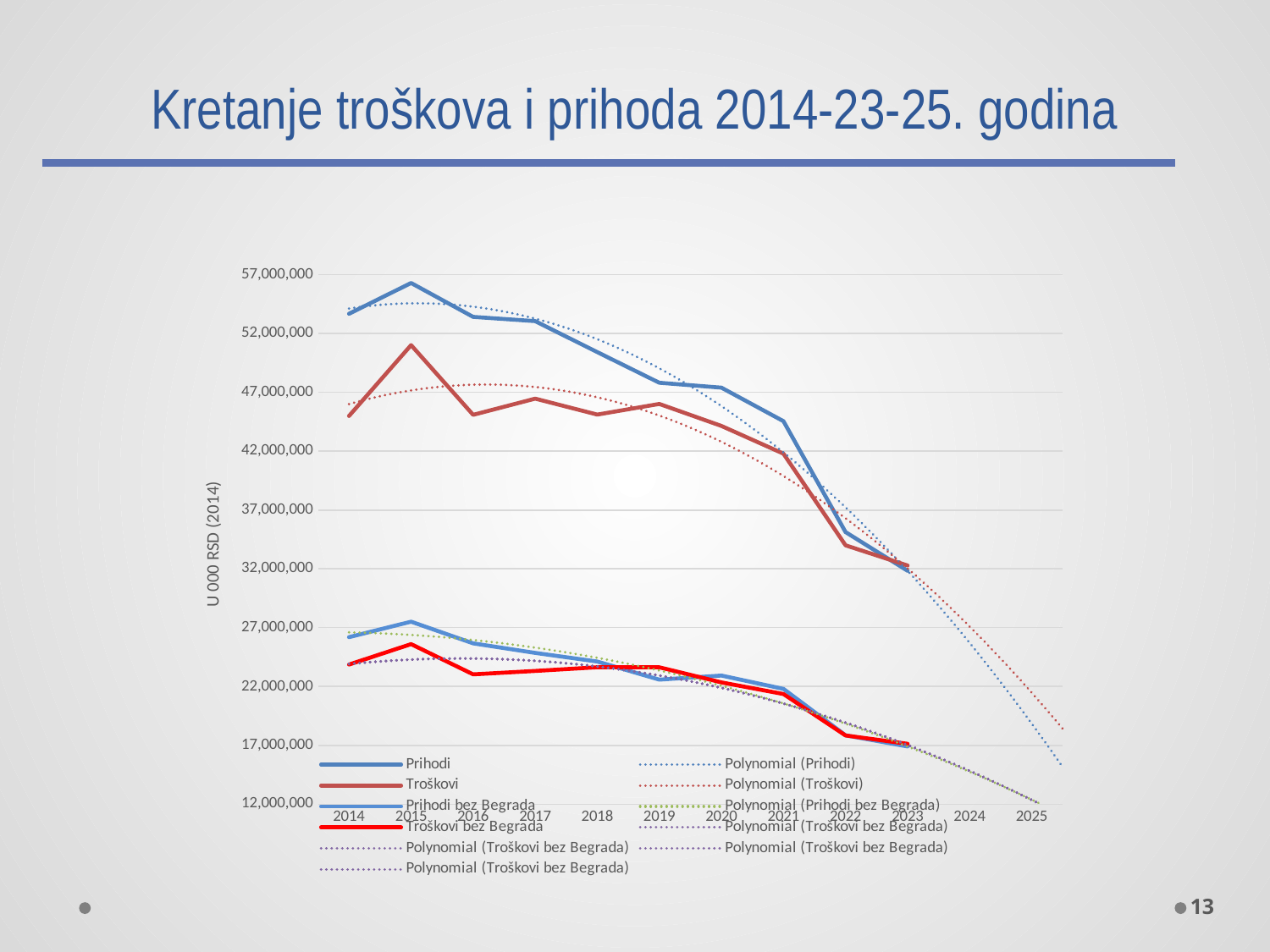
Is the value of Troškovi in 2022 greater or less than 37,000,000? less What is the label on the vertical axis of the chart? U 000 RSD (2014) Is the value of Prihodi in 2015 greater or less than 52,000,000? greater In which year does the Prihodi series reach its highest value? 2015 In which year does the Prihodi series reach its lowest value? 2023 Does the Prihodi series generally rise or fall from 2015 to 2023? fall How many years are labelled along the x axis of the chart? 12 In which year does the Troškovi series reach its highest value? 2015 What kind of chart is shown on the slide? line chart Which series has the larger value in 2015, Prihodi or Troškovi? Prihodi What is the title of the chart? Kretanje troškova i prihoda 2014-23-25. godina Is the value of Prihodi in 2021 greater or less than 47,000,000? less